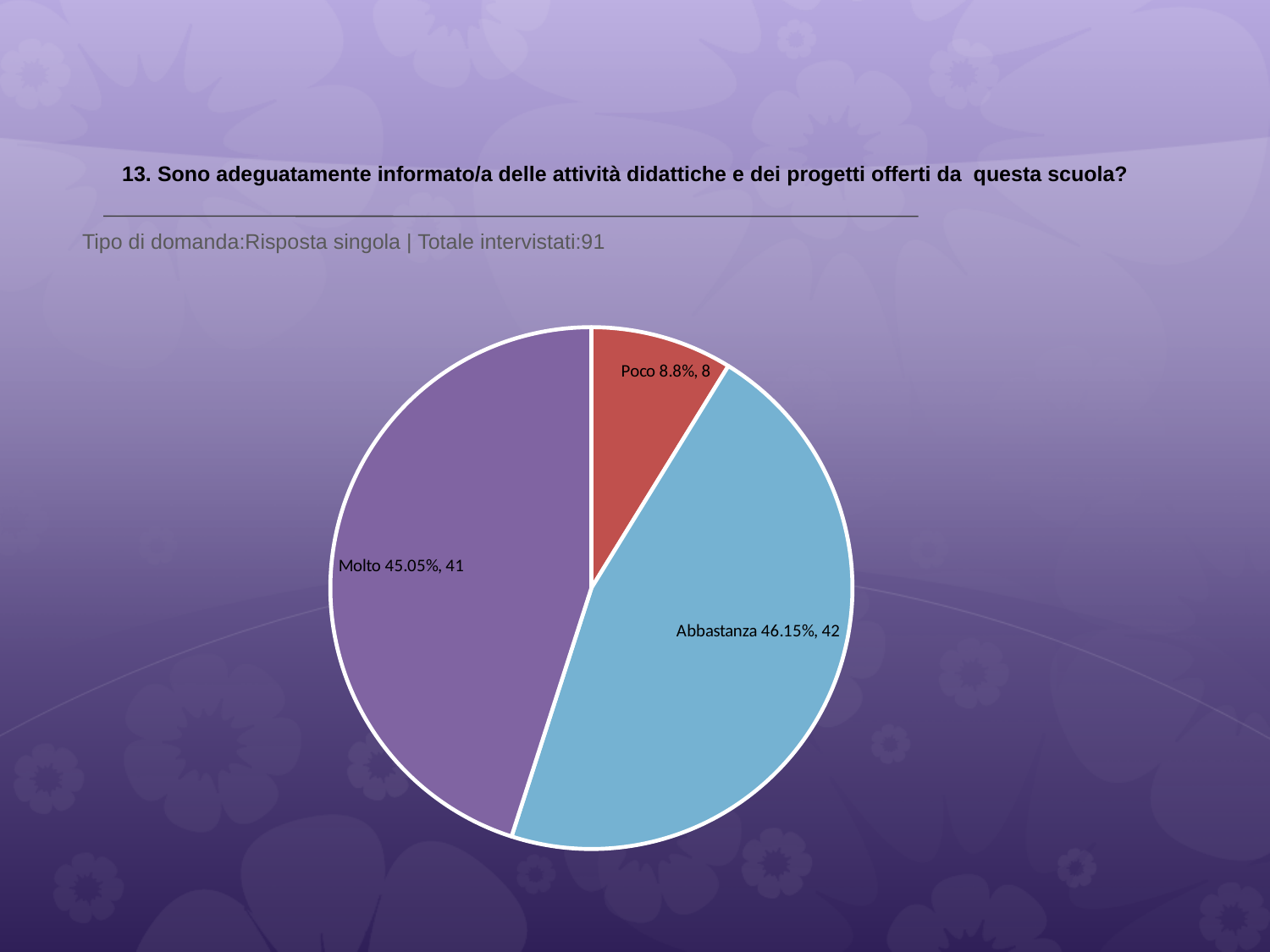
Which has more respondents, "Molto" or "Poco"? Molto Which response has the largest slice in the pie chart? Abbastanza What is the total number of respondents (Totale intervistati) shown on the slide? 91 How many respondents answered "Molto"? 41 What kind of chart is shown on the slide? pie chart How many respondents answered "Abbastanza"? 42 Which response has the smallest slice in the pie chart? Poco What percentage of respondents answered "Poco"? 8.8% What share of the pie does the "Molto" slice represent? 45.05% How many more respondents answered "Abbastanza" than "Poco"? 34 How many slices does the pie chart have? 3 What colour is the "Poco" slice of the pie chart? red